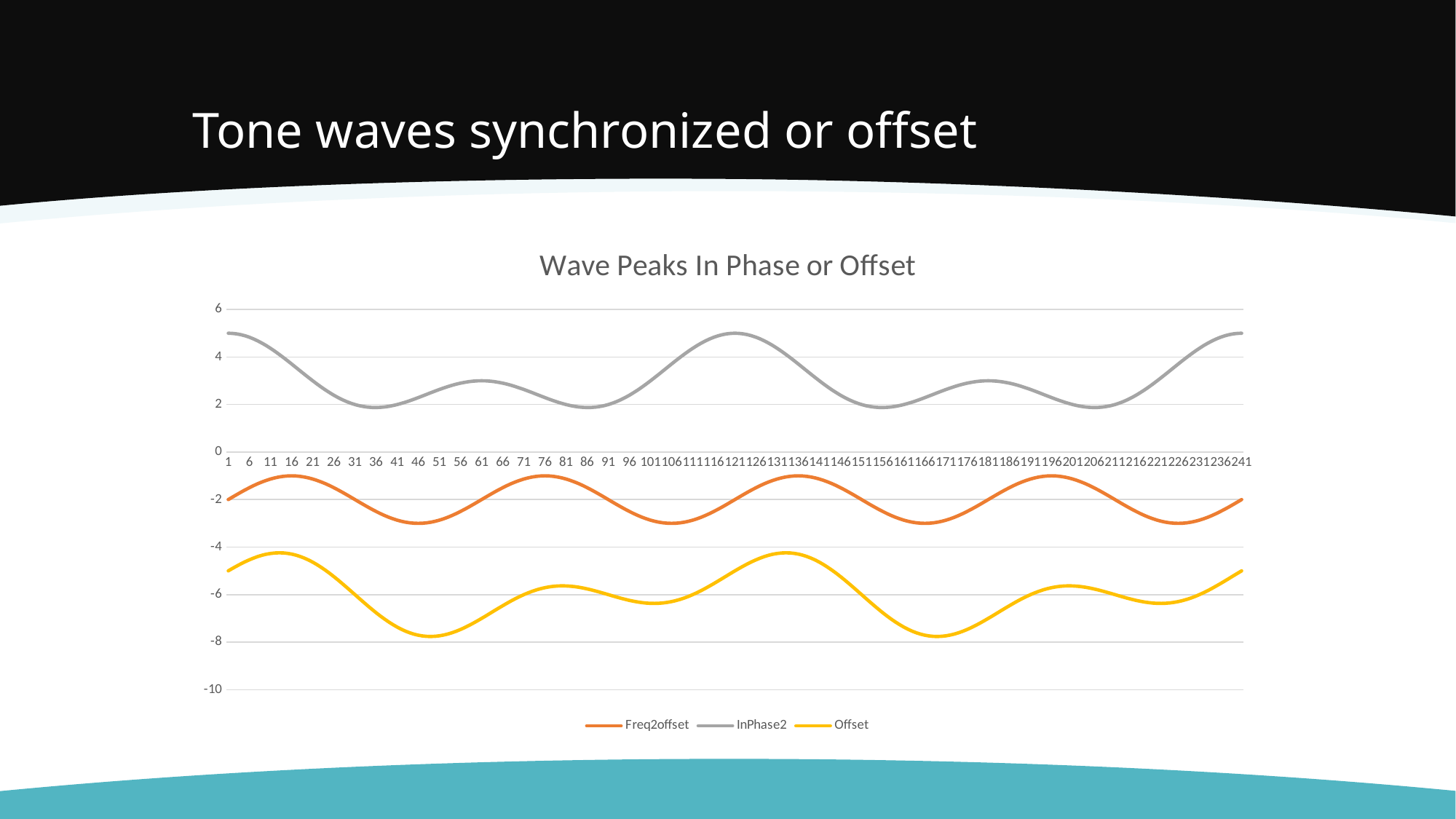
Is the value of Offset at x = 46 greater or less than -6? less Which series is drawn in gray according to the legend? InPhase2 Is the value of InPhase2 at x = 1 greater or less than 4? greater What kind of chart is shown on the slide? line chart At x = 121, which series has the larger value, InPhase2 or Freq2offset? InPhase2 What is the title of the chart? Wave Peaks In Phase or Offset How many series does the legend list? 3 Which series reaches the highest value on the chart? InPhase2 Does the Offset line rise or fall between x = 1 and x = 16? rise Does the InPhase2 line rise or fall between x = 1 and x = 36? fall Is the value of Freq2offset at x = 16 greater or less than -2? greater Which series reaches the lowest value on the chart? Offset